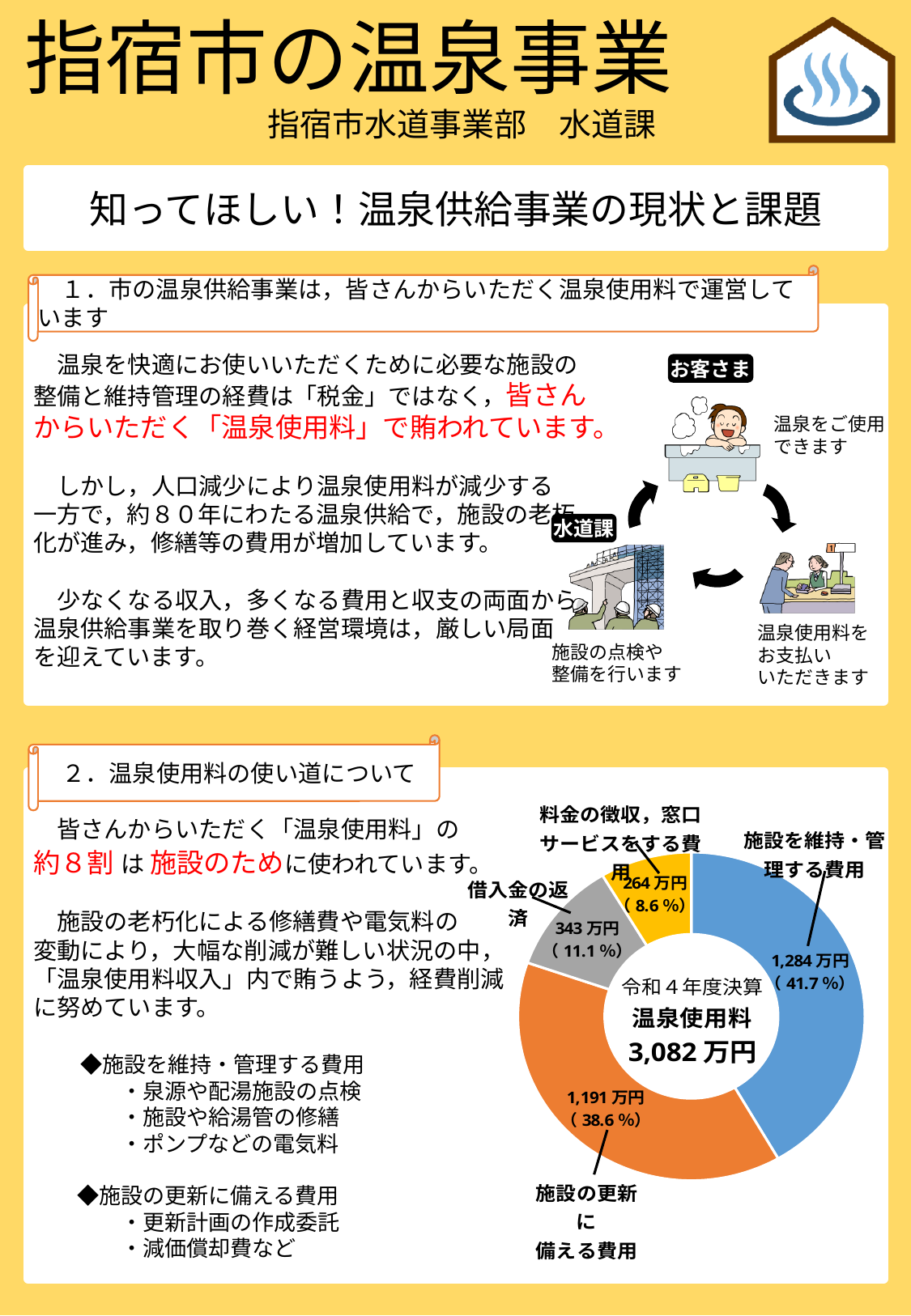
What is the difference between 施設を維持・管理する費用 and 施設の更新に備える費用? 93万円 What is the value for 施設の更新に備える費用? 1,191万円 What is the value for 借入金の返済? 343万円 What is the value for 料金の徴収、窓口サービスをする費用? 264万円 What is the total amount shown in the centre of the pie chart? 3,082万円 Which category has the smallest slice of the pie? 料金の徴収、窓口サービスをする費用 What kind of chart is shown on the slide? Pie (donut) chart What is the value for 施設を維持・管理する費用? 1,284万円 What share of the pie does 施設を維持・管理する費用 represent? 41.7% What share of the pie does 借入金の返済 represent? 11.1% Which category has the largest slice of the pie? 施設を維持・管理する費用 How many categories does the pie chart show? 4